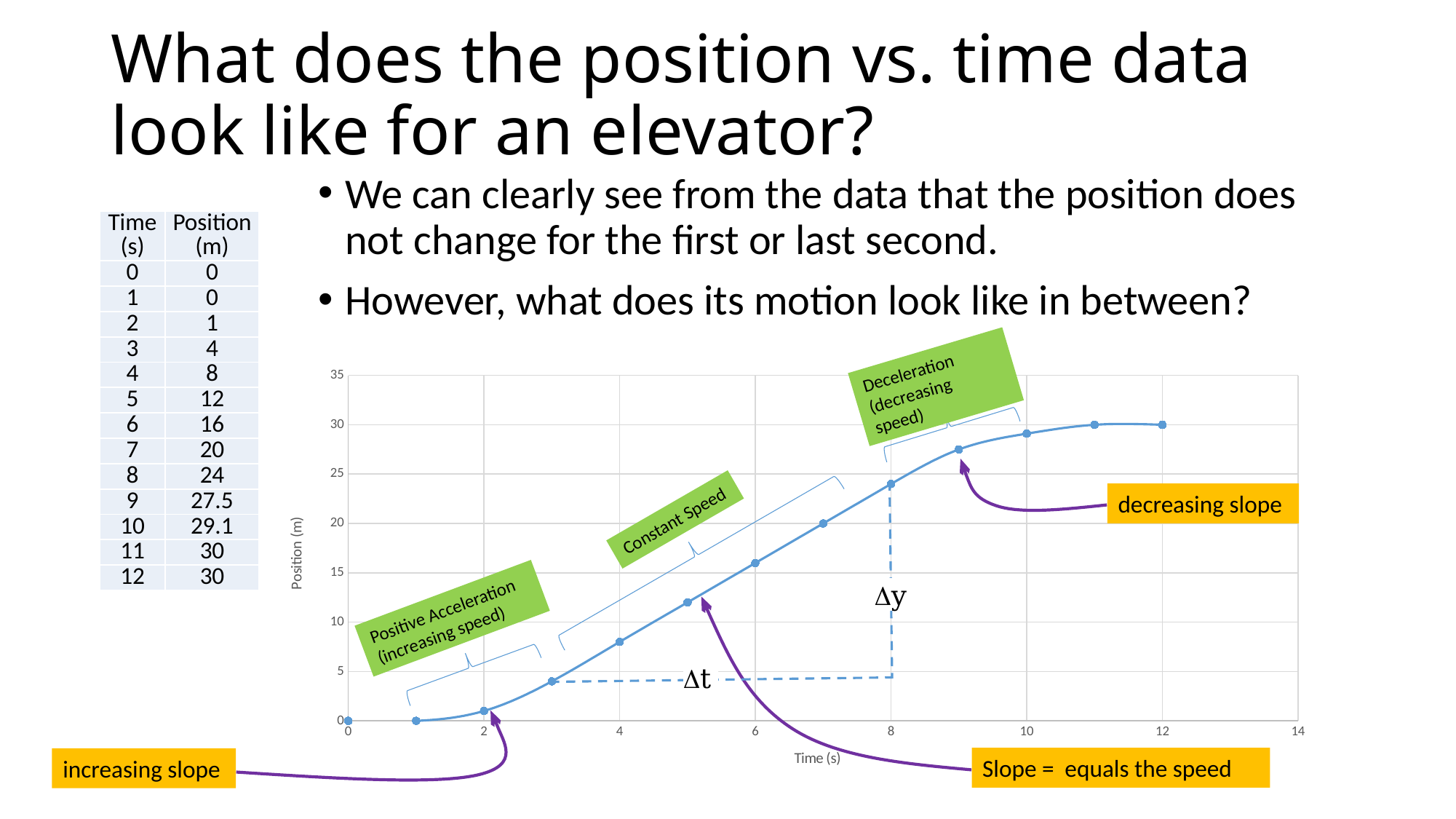
What kind of chart is shown on the slide? scatter chart with a smooth line What is the maximum position value plotted on the chart? 30 What is the position at time 5 s? 12 How many data points are plotted on the chart? 13 What is the position at time 9 s? 27.5 What is the position at time 10 s? 29.1 What is the difference between the position at 8 s and the position at 3 s? 20 Is the position at time 7 s greater or less than 15? greater What is the label of the y axis of the chart? Position (m) What is the position at time 2 s? 1 Does the position rise or fall as time increases along the x axis? rises Which is larger, the position at 6 s or the position at 4 s? 6 s